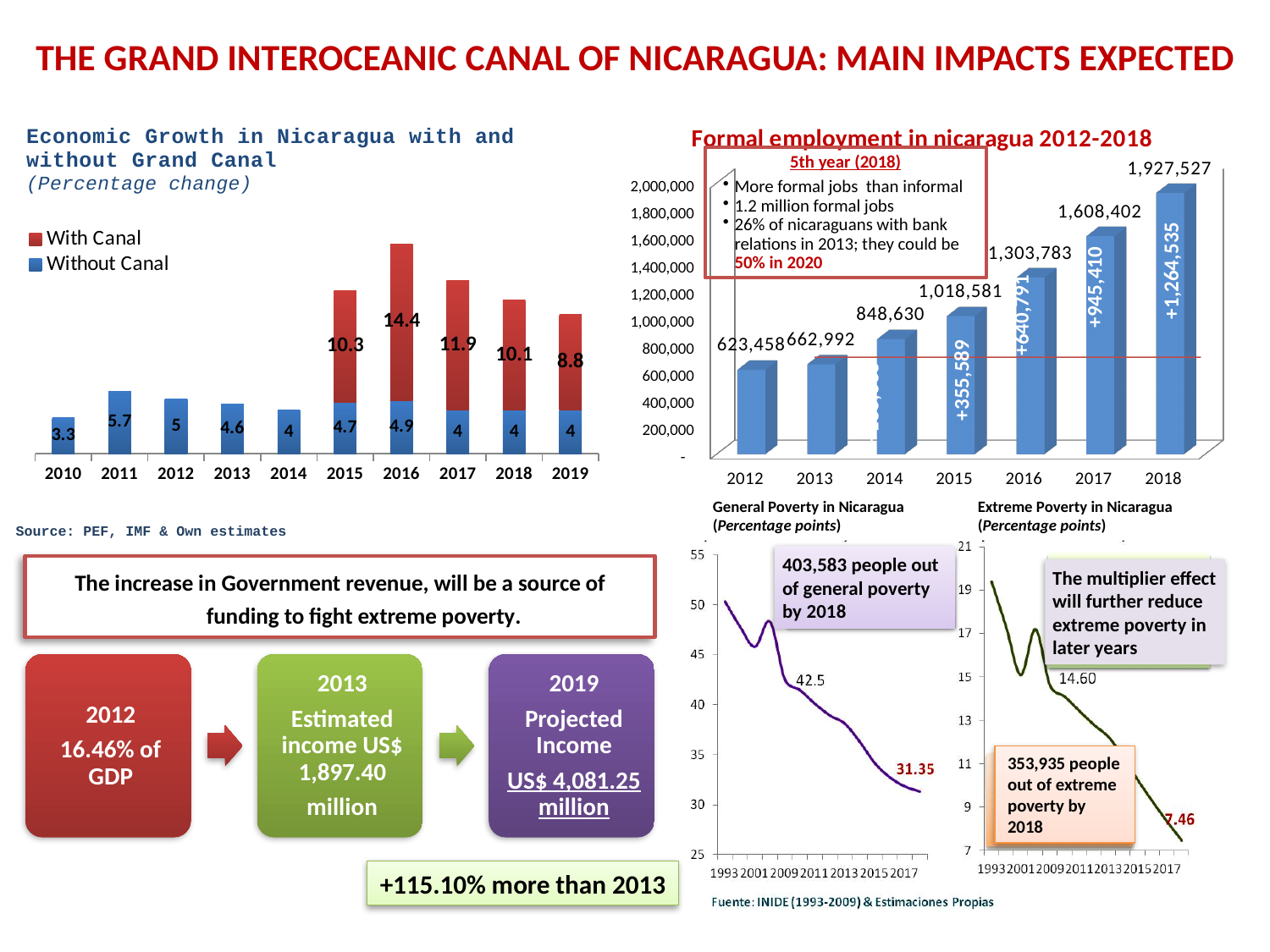
In the 'Economic Growth in Nicaragua with and without Grand Canal' chart, what is the With Canal value for 2016? 14.4 In the 'Economic Growth in Nicaragua with and without Grand Canal' chart, which year has the lowest Without Canal value? 2010 In the 'Extreme Poverty in Nicaragua' chart, what is the final labelled value at the end of the line? 7.46 In the 'Formal employment in nicaragua 2012-2018' chart, do the values rise or fall from 2012 to 2018? rise In the 'Economic Growth in Nicaragua with and without Grand Canal' chart, how many years are shown on the x axis? 10 In the 'Formal employment in nicaragua 2012-2018' chart, what is the value for 2012? 623,458 In the 'Formal employment in nicaragua 2012-2018' chart, what is the difference between the 2018 and 2017 values? 319,125 In the 'Economic Growth in Nicaragua with and without Grand Canal' chart, how many series does the legend list? 2 In the 'Economic Growth in Nicaragua with and without Grand Canal' chart, what is the Without Canal value for 2011? 5.7 What kind of chart is the 'Formal employment in nicaragua 2012-2018' chart? bar chart In the 'Economic Growth in Nicaragua with and without Grand Canal' chart, which year has the highest With Canal value? 2016 In the 'Formal employment in nicaragua 2012-2018' chart, what is the value for 2018? 1,927,527